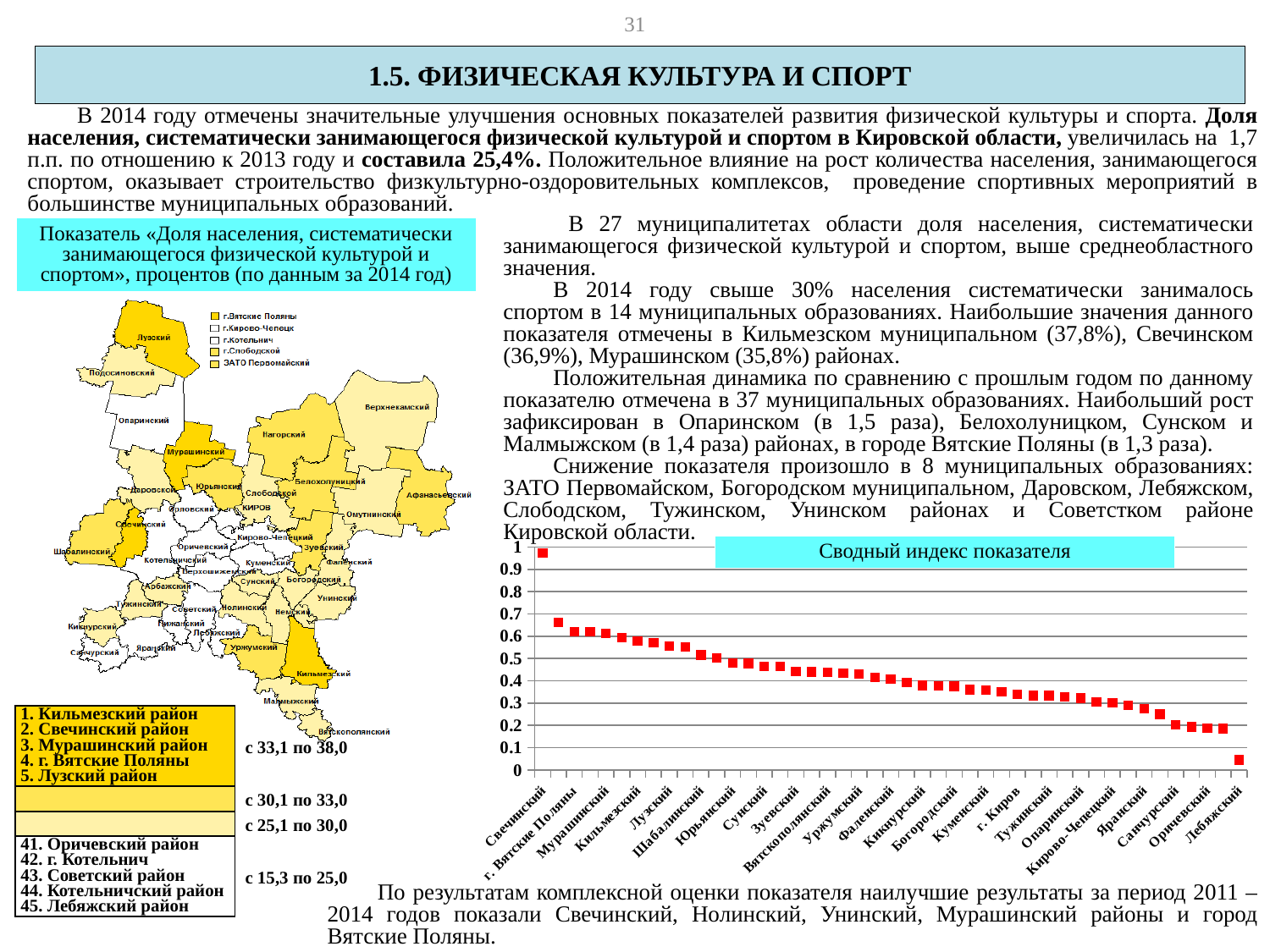
What is the maximum value shown on the y axis of the "Сводный индекс показателя" chart? 1 In the "Сводный индекс показателя" chart, which municipality has the lowest value? Лебяжский In the "Сводный индекс показателя" chart, which municipality has the highest value? Свечинский In the "Сводный индекс показателя" chart, which has the larger value: г. Вятские Поляны or Оричевский? г. Вятские Поляны What kind of chart is the "Сводный индекс показателя" chart? scatter (dot) chart In the "Сводный индекс показателя" chart, is the value for Лебяжский greater or less than 0.3? less What is the title of the chart on the right side of the slide? Сводный индекс показателя In the "Сводный индекс показателя" chart, is the value for Оричевский greater or less than 0.4? less In the "Сводный индекс показателя" chart, is the value for Свечинский greater or less than 0.9? greater In the "Сводный индекс показателя" chart, which has the larger value: Санчурский or Кильмезский? Кильмезский In the "Сводный индекс показателя" chart, do the values rise or fall from left to right along the x axis? fall